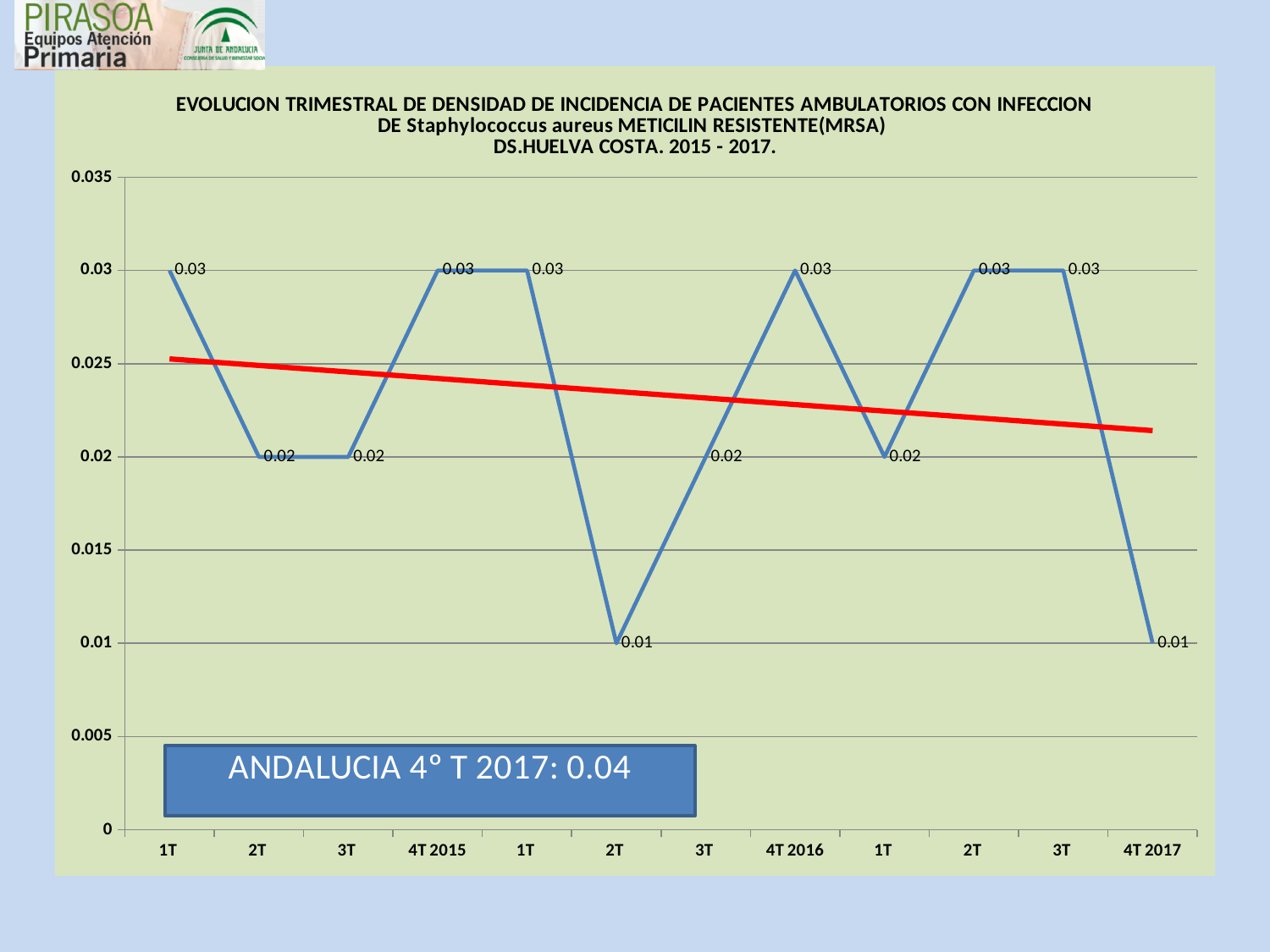
Which is larger, the value at 4T 2015 or the value at 4T 2017? 4T 2015 What is the value at 4T 2017? 0.01 What is the value at 4T 2015? 0.03 How many quarterly points are plotted on the x axis? 12 What is the difference between the values at 4T 2016 and 4T 2017? 0.02 What is the value at 4T 2016? 0.03 What is the value at the 2T point that follows 4T 2015 (2T 2016)? 0.01 Does the red trend line rise or fall from left to right? fall What is the lowest value plotted on the chart? 0.01 What type of chart is shown on the slide? line chart What is the value at the first point on the x axis (1T 2015)? 0.03 What is the highest value plotted on the chart? 0.03